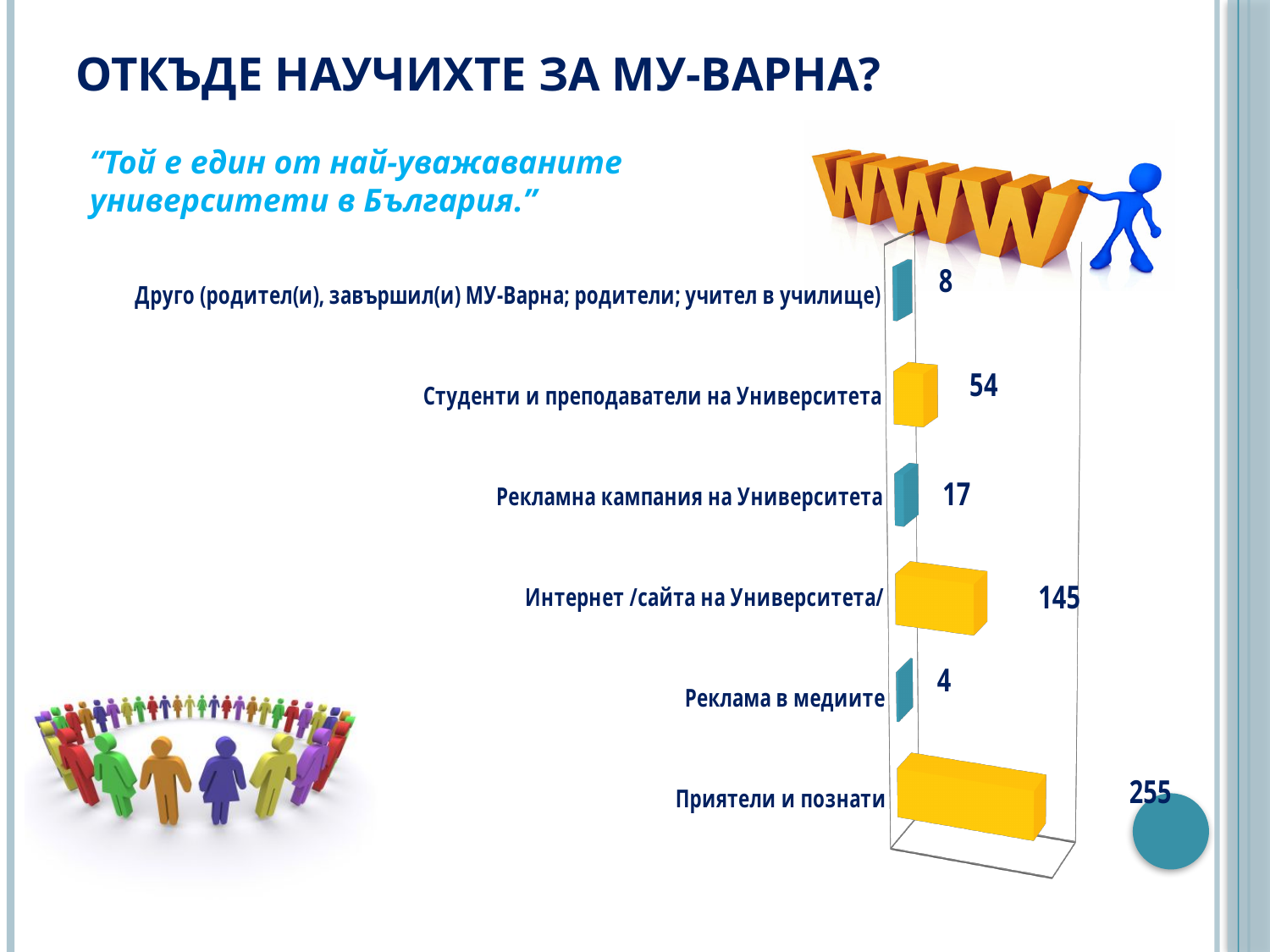
Which is larger: the value for "Студенти и преподаватели на Университета" or the value for "Рекламна кампания на Университета"? Студенти и преподаватели на Университета What value is shown for "Рекламна кампания на Университета"? 17 What value is shown for "Реклама в медиите"? 4 What value is shown for "Приятели и познати"? 255 Which category has the highest value? Приятели и познати How many categories does the chart show? 6 Which category has the lowest value? Реклама в медиите What is the difference between the values for "Студенти и преподаватели на Университета" and "Рекламна кампания на Университета"? 37 What is the difference between the values for "Приятели и познати" and "Интернет /сайта на Университета/"? 110 What kind of chart is shown on the slide? Bar chart What value is shown for "Интернет /сайта на Университета/"? 145 What value is shown for "Студенти и преподаватели на Университета"? 54